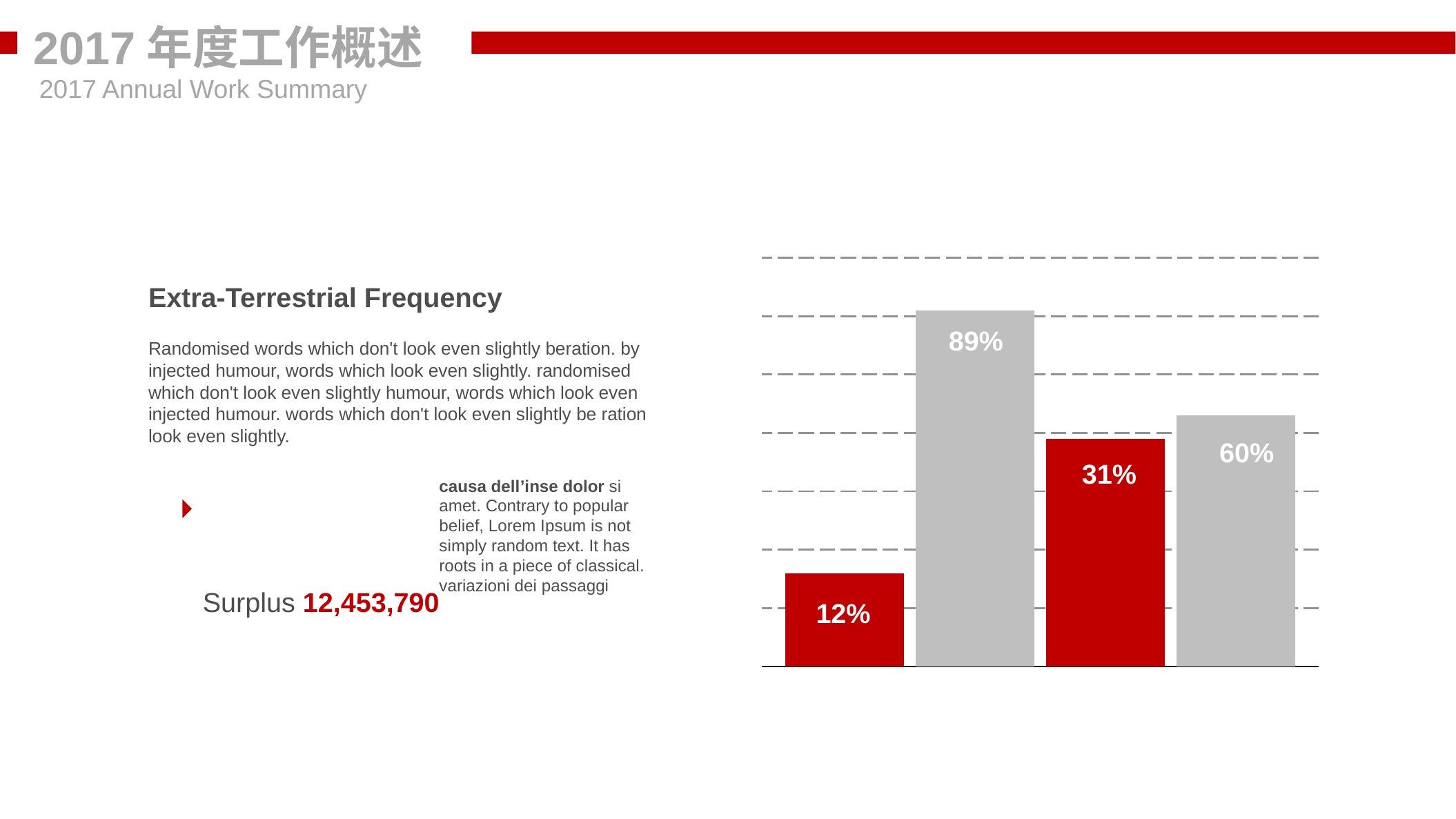
What is the highest value shown in the chart? 89% What is the value shown on the second bar from the left in the chart? 89% What is the value shown on the first (leftmost) bar of the chart? 12% What is the difference between the third bar (31%) and the first bar (12%) in the chart? 19% What is the value shown on the third bar from the left in the chart? 31% What is the value shown on the fourth (rightmost) bar of the chart? 60% What type of chart is shown on the slide? bar chart Which is larger in the chart, the third bar or the fourth bar? the fourth bar (60%) What is the lowest value shown in the chart? 12% What is the difference between the second bar (89%) and the fourth bar (60%) in the chart? 29% What colour are the first and third bars in the chart? red How many bars are plotted in the chart? 4